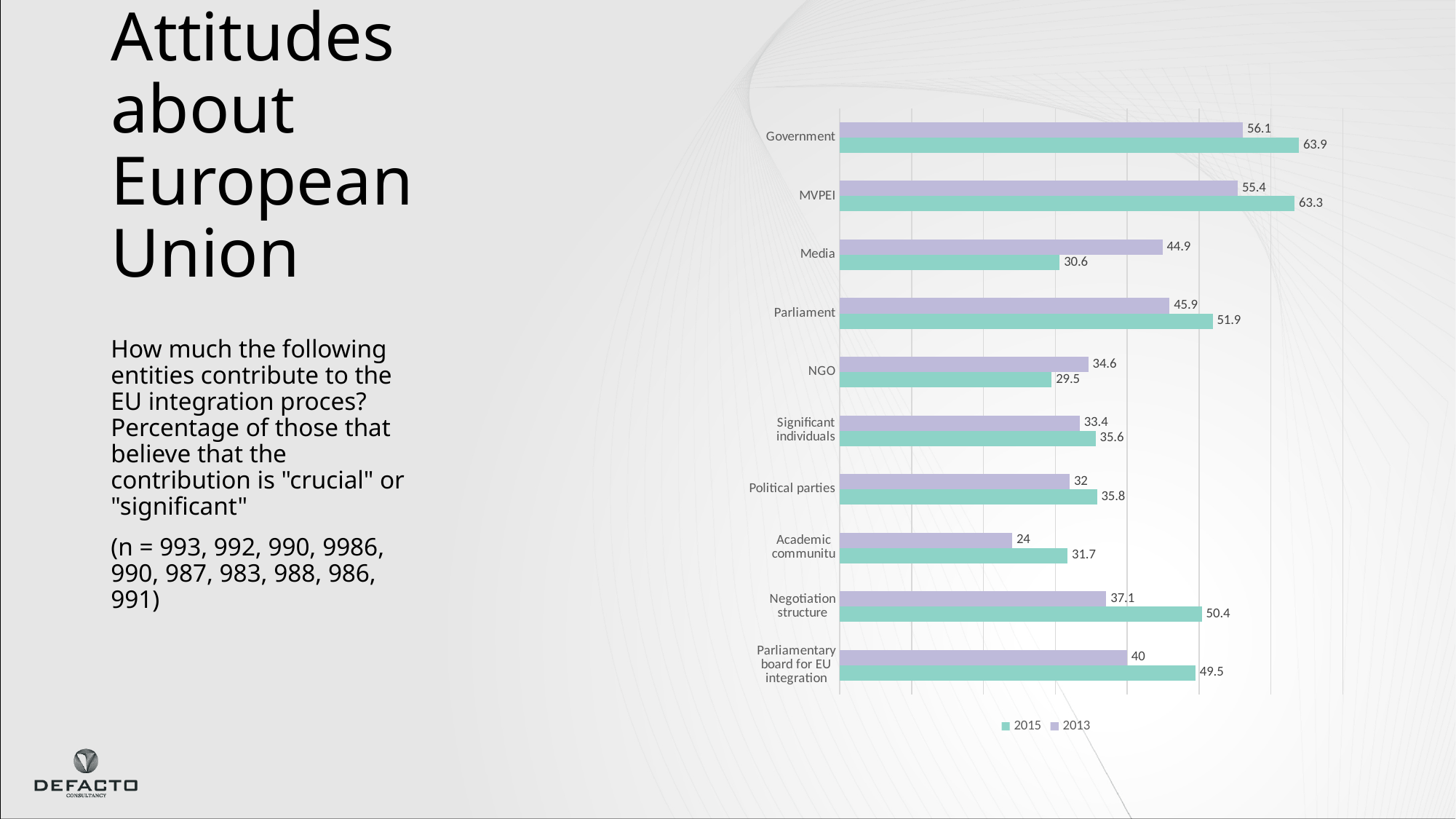
Which colour represents the 2015 series? green What is the 2015 value for Government? 63.9 What is the 2013 value for Media? 44.9 What is the difference between the 2015 and 2013 values for Negotiation structure? 13.3 How many series does the legend list? 2 What is the 2013 value for Academic communitu? 24 Which is larger for Media, the 2015 value or the 2013 value? 2013 What is the 2015 value for Negotiation structure? 50.4 Which category has the highest 2015 value? Government Which category has the lowest 2013 value? Academic communitu How many categories are shown on the chart? 10 What kind of chart is shown on the slide? bar chart